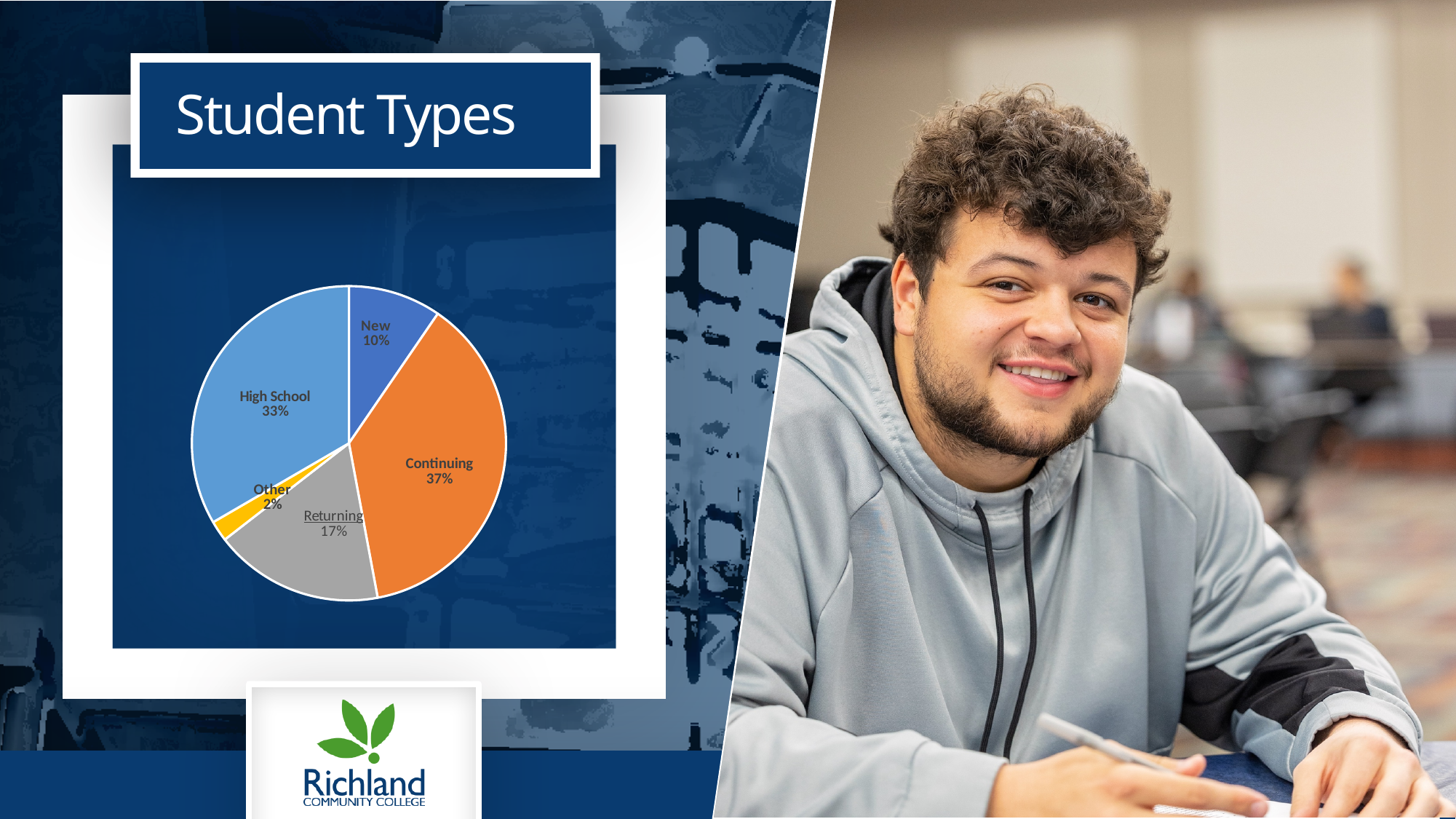
What is the title of the chart? Student Types What percentage of students are High School students? 33% Which student type has the smallest share of the pie? Other What percentage of students are Returning students? 17% What kind of chart is shown on the slide? Pie chart What colour is the Continuing slice of the pie? Orange Which student type has the largest share of the pie? Continuing What percentage of students are New students? 10% What is the difference in percentage points between Continuing and Returning students? 20 How many student types are shown in the pie chart? 5 What percentage of students are Continuing students? 37% Which is larger, the share of New students or the share of Returning students? Returning